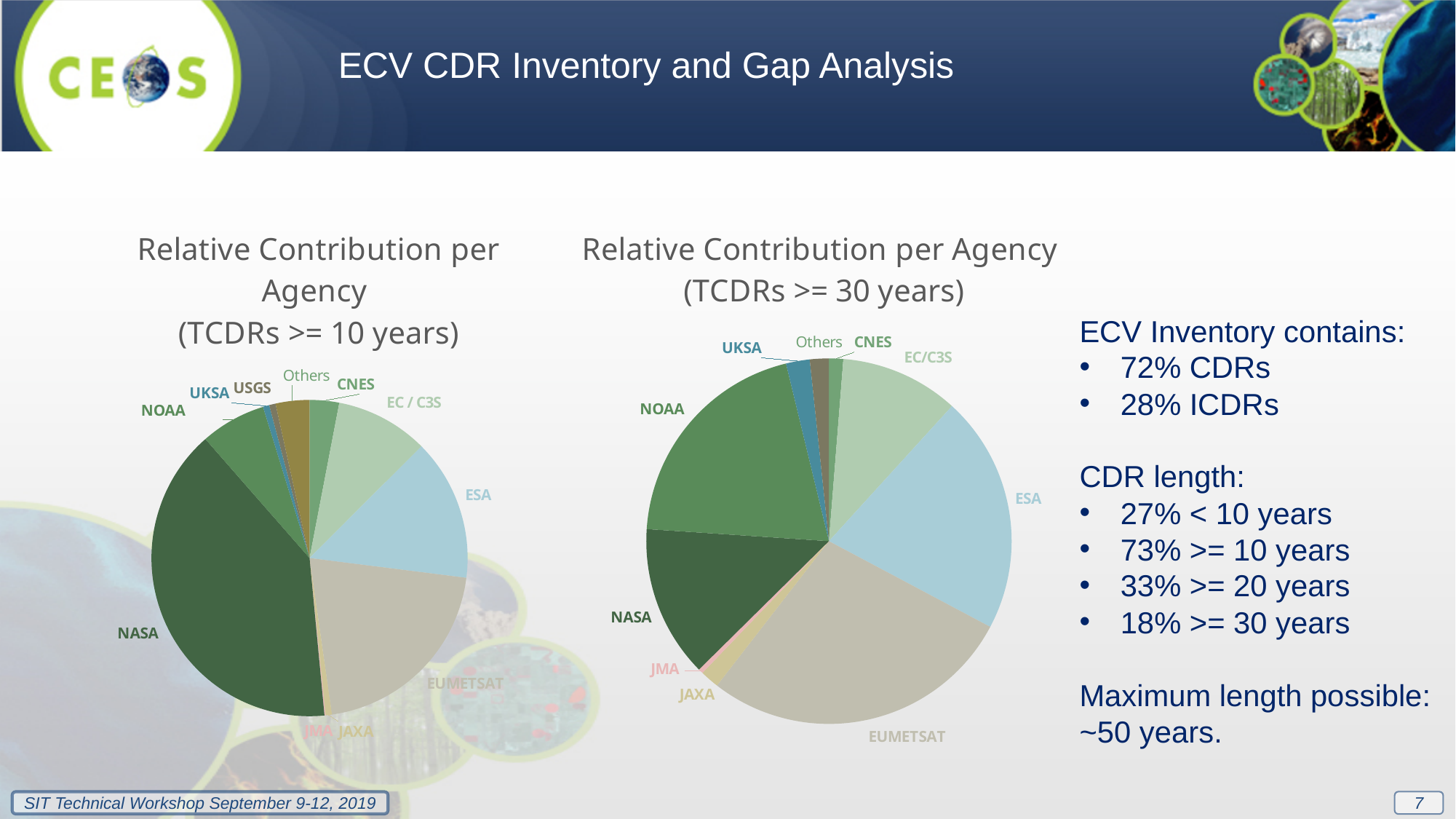
In the left chart (TCDRs >= 10 years), which slice is larger, NASA or EUMETSAT? NASA In the left chart (TCDRs >= 10 years), which agency has the largest slice? NASA In the right chart (TCDRs >= 30 years), which slice is larger, ESA or EC/C3S? ESA How many slices are labelled in the right chart (TCDRs >= 30 years)? 10 What is the title of the right pie chart? Relative Contribution per Agency (TCDRs >= 30 years) Which agency label appears in the left chart (TCDRs >= 10 years) but not in the right chart (TCDRs >= 30 years)? USGS What kind of chart is the left chart, 'Relative Contribution per Agency (TCDRs >= 10 years)'? pie chart In the left chart (TCDRs >= 10 years), which slice is larger, ESA or EC / C3S? ESA How many slices are labelled in the left chart (TCDRs >= 10 years)? 11 What kind of chart is the right chart, 'Relative Contribution per Agency (TCDRs >= 30 years)'? pie chart In the right chart (TCDRs >= 30 years), which agency has the largest slice? EUMETSAT